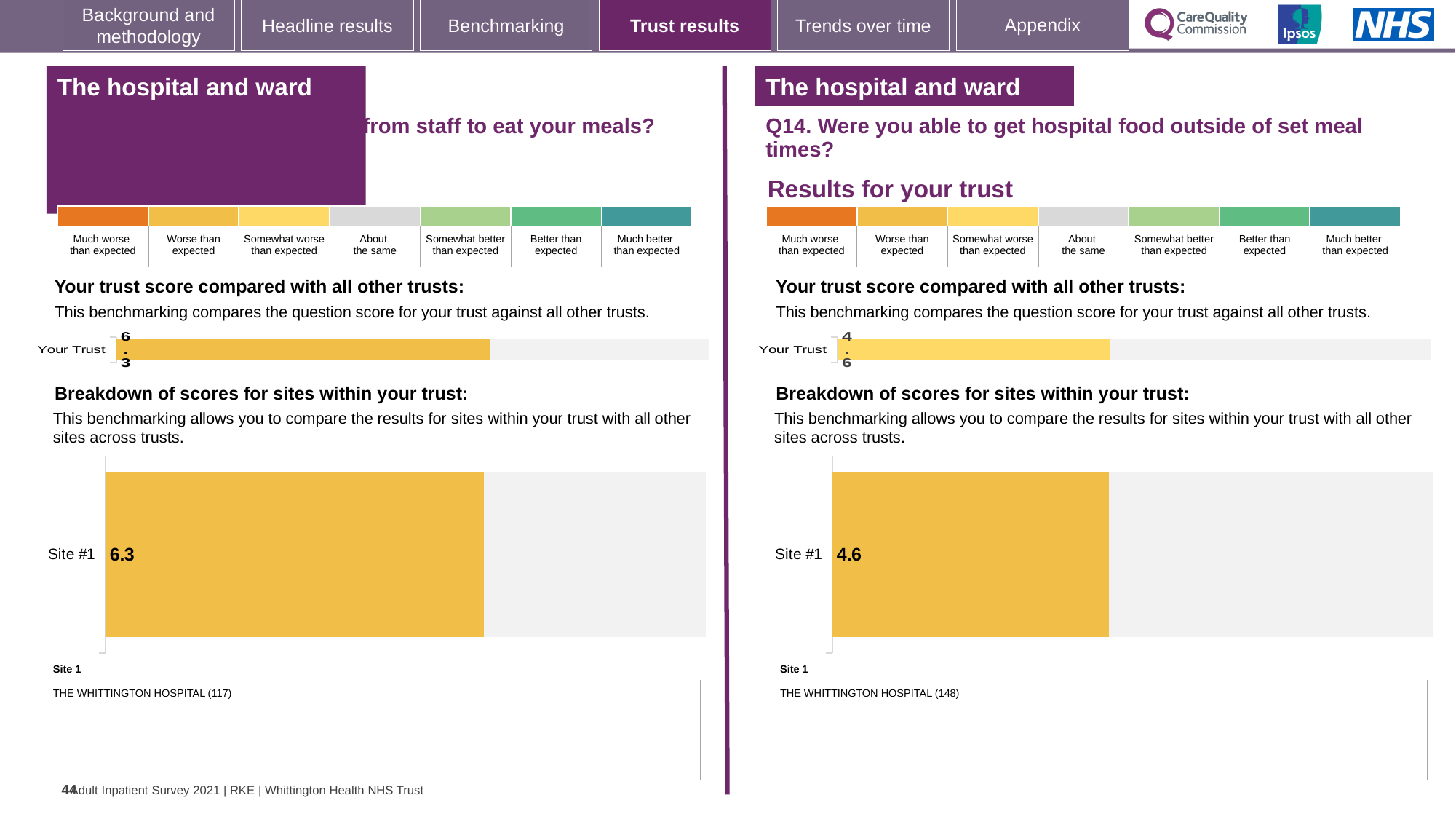
Which panel's 'Your Trust' bar shows the larger score, the left-hand panel or the right-hand panel (Q14)? Left-hand panel Which panel's Site #1 bar shows the larger score, the left-hand panel or the right-hand panel (Q14)? Left-hand panel What type of chart is used to show the breakdown of scores for sites on the right-hand panel (Q14)? Bar chart On the right-hand panel (Q14), which hospital is listed as Site 1 below the sites chart? THE WHITTINGTON HOSPITAL (148) On the right-hand panel (Q14), what is the score shown for 'Your Trust' in the trust comparison bar chart? 4.6 What is the difference between the Site #1 score on the left-hand panel and the Site #1 score on the right-hand panel (Q14)? 1.7 How many sites are shown in the breakdown of scores for sites chart on the right-hand panel (Q14)? 1 On the right-hand panel (Q14), what is the score for Site #1 in the breakdown of scores for sites chart? 4.6 On the left-hand panel, what is the score for Site #1 in the breakdown of scores for sites chart? 6.3 On the left-hand panel, which hospital is listed as Site 1 below the sites chart? THE WHITTINGTON HOSPITAL (117) On the left-hand panel, what is the score shown for 'Your Trust' in the trust comparison bar chart? 6.3